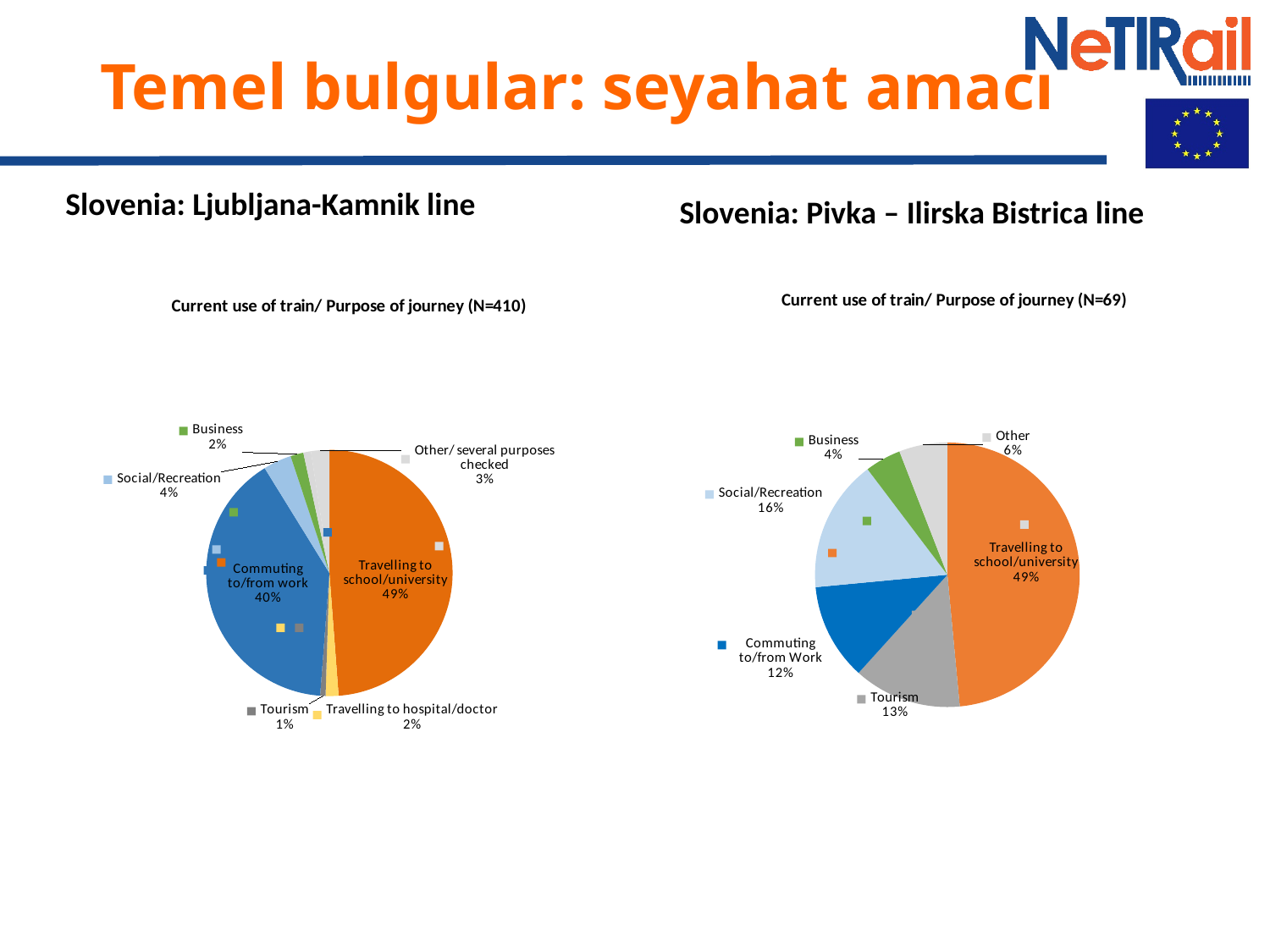
In the Pivka – Ilirska Bistrica line chart, which is larger: the share for tourism or the share for commuting to/from work? Tourism In the Ljubljana-Kamnik line chart, what share of journeys is commuting to/from work? 40% What is the sample size (N) given in the title of the Pivka – Ilirska Bistrica line chart? 69 In the Pivka – Ilirska Bistrica line chart, which purpose has the largest share? Travelling to school/university In the Ljubljana-Kamnik line chart, which purpose has the smallest share? Tourism In the Ljubljana-Kamnik line chart, what share of journeys is for travelling to school/university? 49% In the Pivka – Ilirska Bistrica line chart, what share of journeys is for tourism? 13% In the Pivka – Ilirska Bistrica line chart, what share of journeys is for social/recreation? 16% In the Ljubljana-Kamnik line chart, what is the difference between the shares for travelling to school/university and commuting to/from work? 9 percentage points In the Pivka – Ilirska Bistrica line chart, how many purpose categories are shown in the pie? 6 What kind of chart is used for the Ljubljana-Kamnik line data? Pie chart